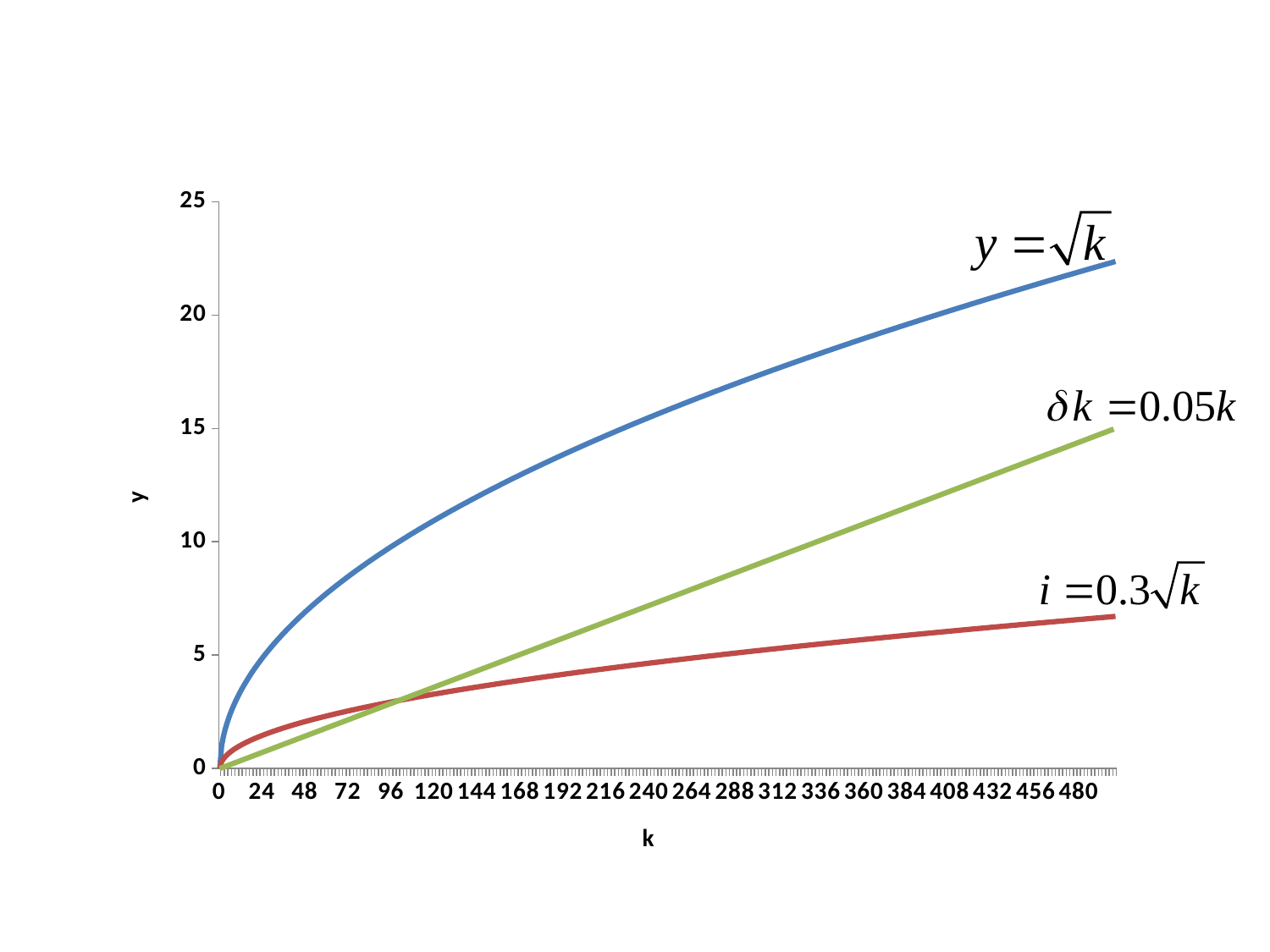
At k = 240, which curve is higher: δk = 0.05k or i = 0.3√k? δk = 0.05k Is the value of the δk = 0.05k curve at k = 480 greater or less than 20? less Does the y = √k curve rise or fall as k increases? rise Which curve has the lowest value at k = 480? i = 0.3√k What kind of chart is shown on the slide? line chart What colour is the y = √k curve? blue Which curve has the highest value at k = 240? y = √k Is the value of the y = √k curve at k = 144 greater or less than 10? greater Is the value of the i = 0.3√k curve at k = 480 greater or less than 10? less At k = 48, which curve is higher: i = 0.3√k or δk = 0.05k? i = 0.3√k How many curves are plotted on the chart? 3 What is the label on the horizontal axis? k